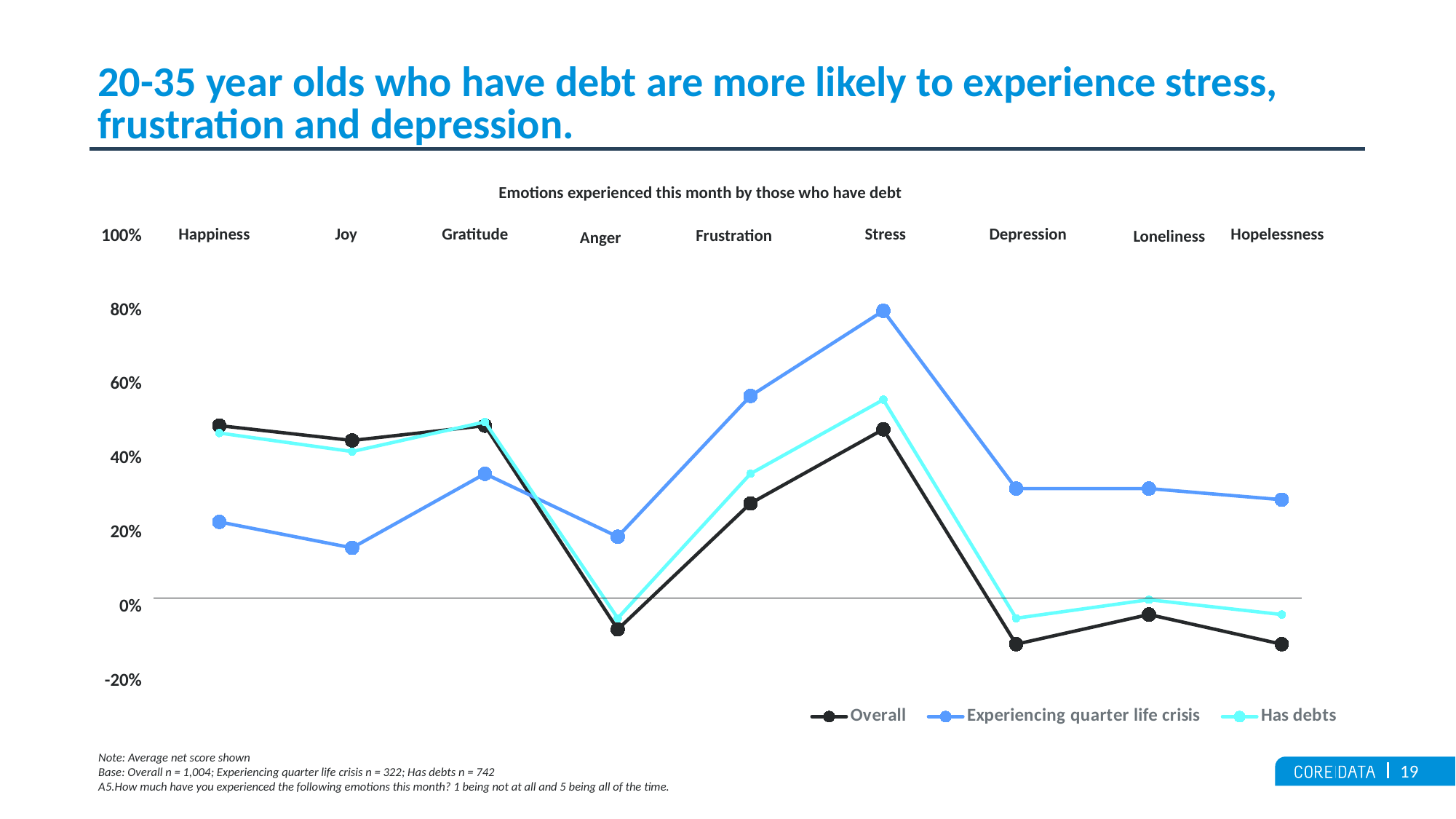
What kind of chart is shown on the slide? Line chart How many emotions are plotted along the x axis? 9 What is the title of the chart? Emotions experienced this month by those who have debt For Frustration, which series has the larger value: Overall or Experiencing quarter life crisis? Experiencing quarter life crisis Is the Has debts value for Frustration greater or less than 20%? greater Is the Overall value for Anger greater or less than 0%? less Does the Experiencing quarter life crisis line rise or fall from Stress to Depression? fall For Stress, which series has the larger value: Overall or Has debts? Has debts For the Experiencing quarter life crisis series, which emotion has the lowest value? Joy How many series does the legend list? 3 Is the Experiencing quarter life crisis value for Stress greater or less than 60%? greater For the Experiencing quarter life crisis series, which emotion has the highest value? Stress